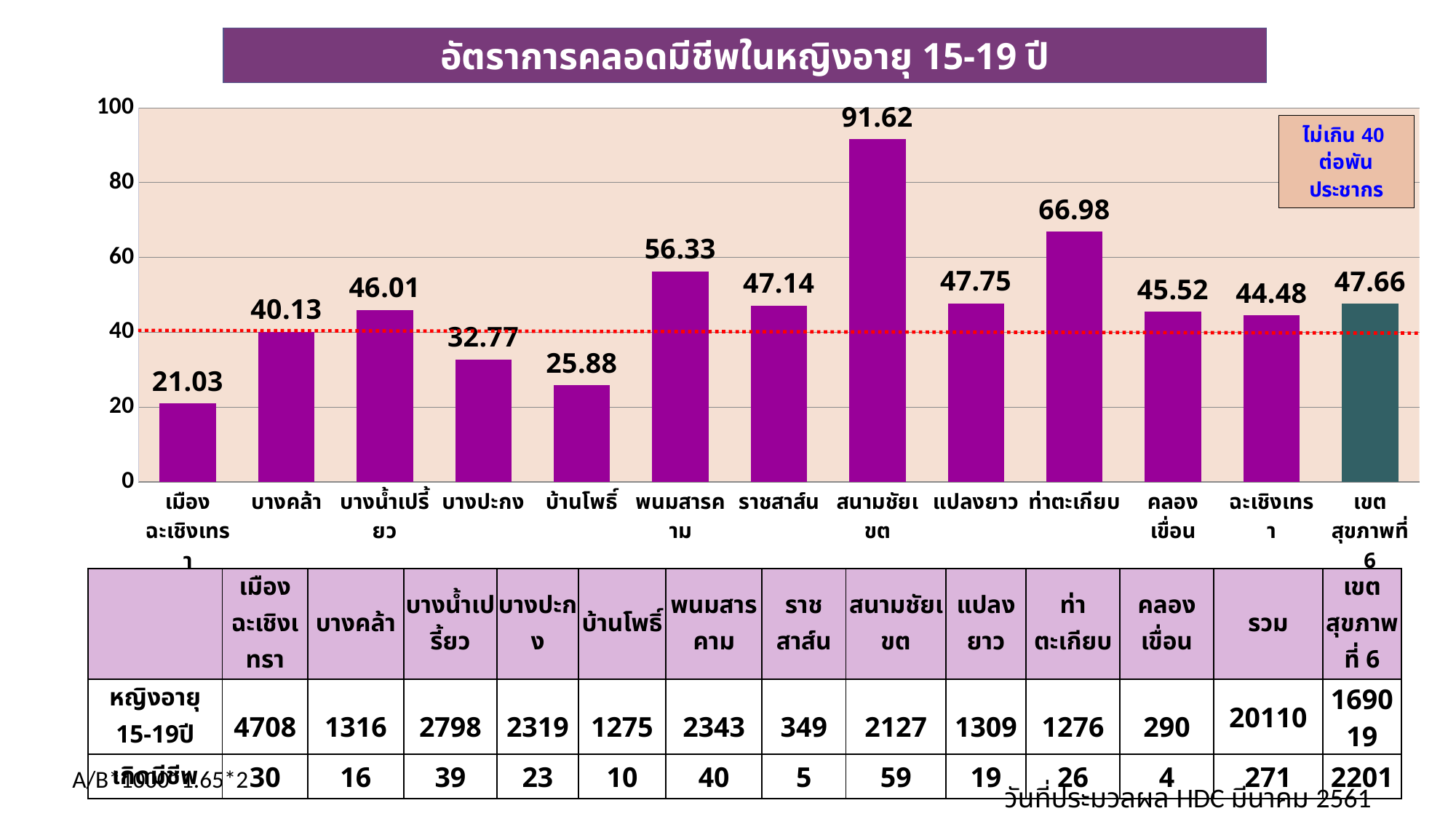
At what value is the red dotted reference line drawn? 40 Which category has the highest value? สนามชัยเขต What kind of chart is shown on the slide? bar chart What is the value for สนามชัยเขต? 91.62 Which category has the lowest value? เมืองฉะเชิงเทรา How many bars are shown in the chart? 13 What is the value for เขตสุขภาพที่ 6? 47.66 What is the difference between the values for ท่าตะเกียบ and บางคล้า? 26.85 Is the value for บางปะกง greater or less than 40? less What is the value for บ้านโพธิ์? 25.88 Which is larger, the value for พนมสารคาม or the value for แปลงยาว? พนมสารคาม What is the title of the chart? อัตราการคลอดมีชีพในหญิงอายุ 15-19 ปี